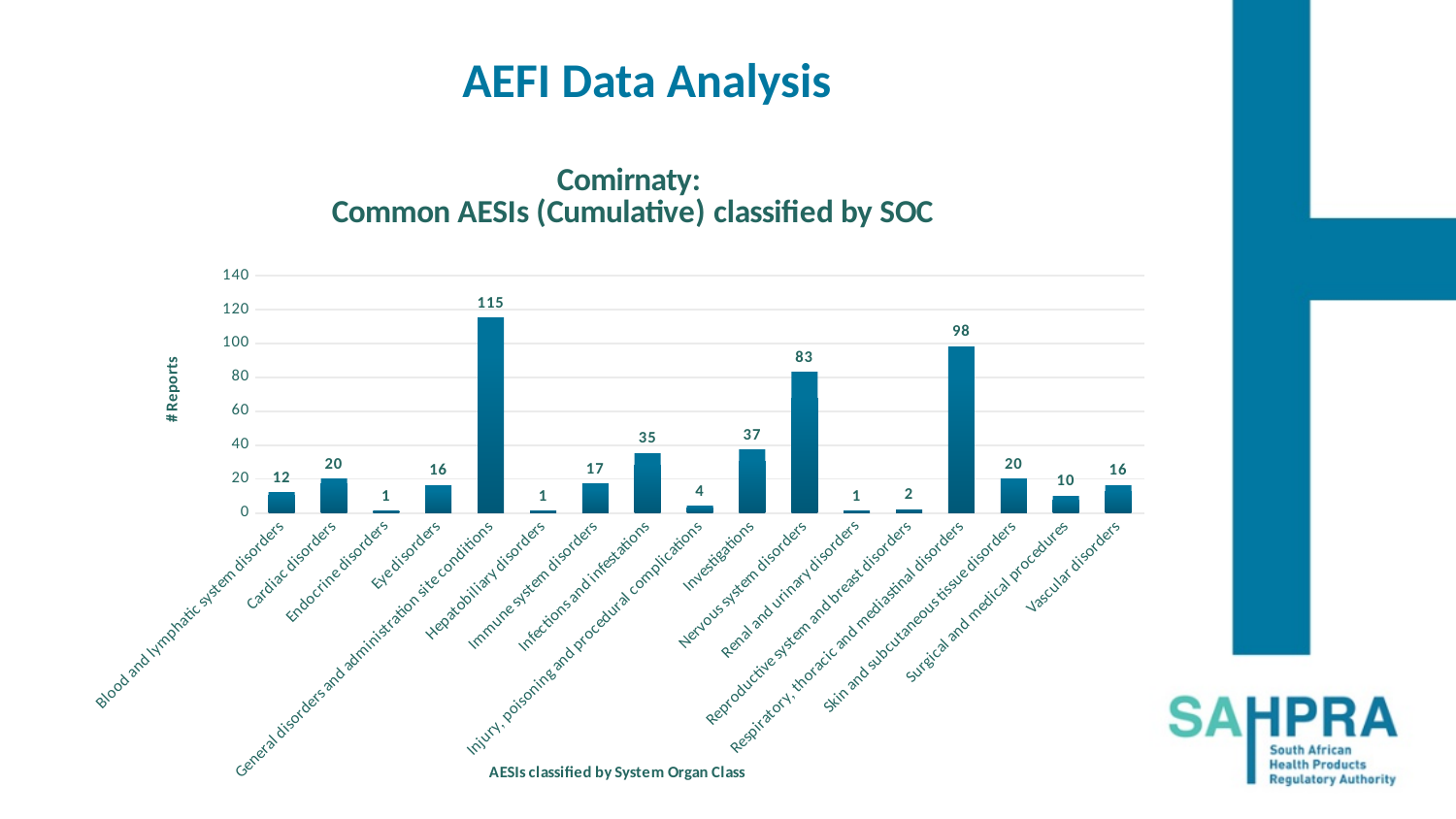
How many system organ class categories are plotted on the chart? 17 How many reports are shown for General disorders and administration site conditions? 115 Which has more reports, Nervous system disorders or Respiratory, thoracic and mediastinal disorders? Respiratory, thoracic and mediastinal disorders Which system organ class has the highest number of reports? General disorders and administration site conditions What is the difference in reports between General disorders and administration site conditions and Respiratory, thoracic and mediastinal disorders? 17 How many reports are shown for Respiratory, thoracic and mediastinal disorders? 98 What is the value for Nervous system disorders? 83 What kind of chart is shown on the slide? Bar chart What is the difference in reports between Cardiac disorders and Blood and lymphatic system disorders? 8 Which has more reports, Investigations or Infections and infestations? Investigations What is the label of the vertical axis of the chart? # Reports What is the value for Infections and infestations? 35